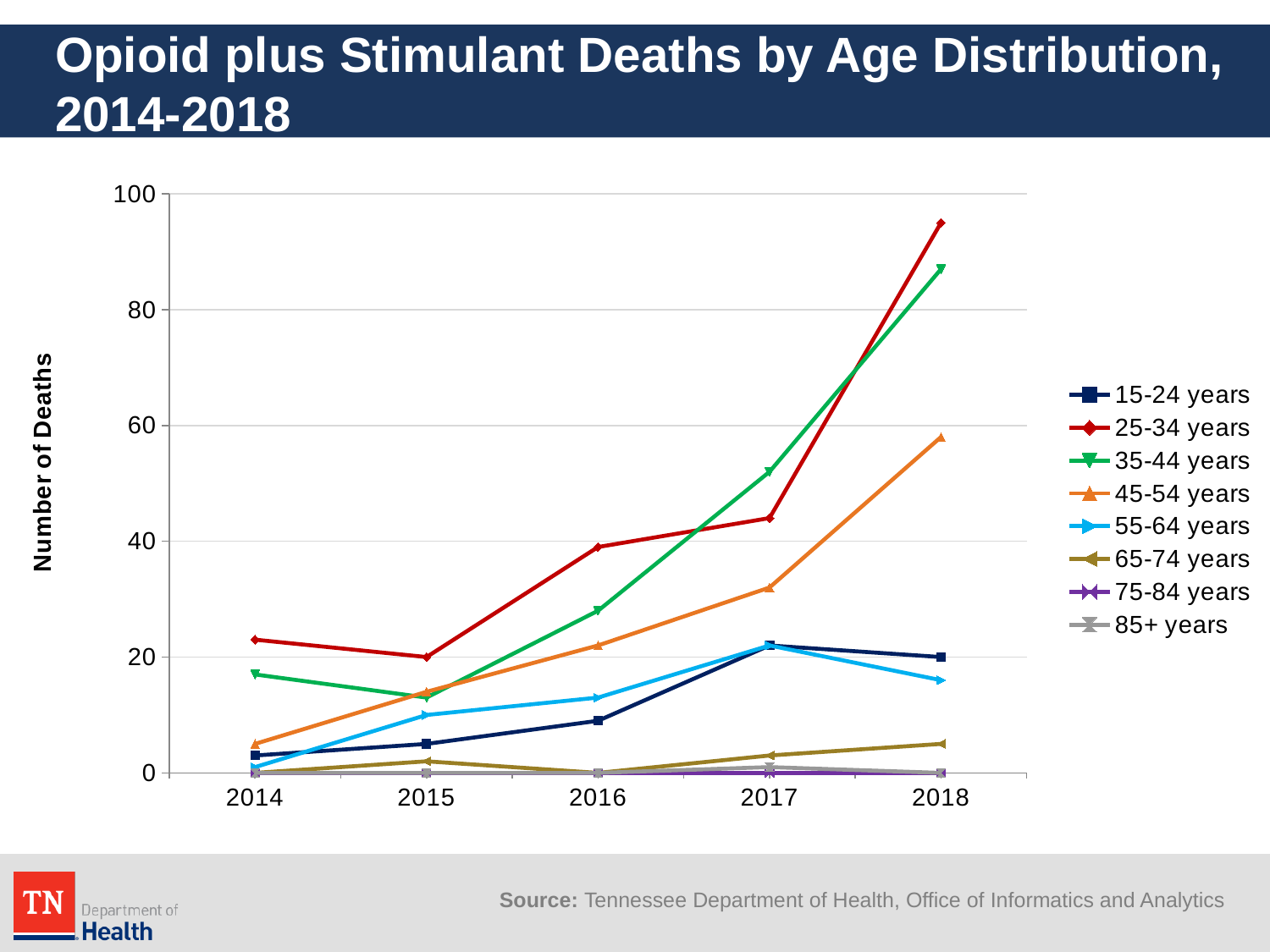
Is the value for 25-34 years in 2018 greater or less than 80? greater How many series does the legend list? 8 Is the value for 35-44 years in 2017 greater or less than 40? greater How many years are shown along the x axis? 5 Is the value for 15-24 years in 2016 greater or less than 20? less In 2014, which is larger: the value for 25-34 years or the value for 35-44 years? 25-34 years What kind of chart is shown on the slide? line chart Which age group has the highest number of deaths in 2018? 25-34 years Do the values for 55-64 years rise or fall from 2017 to 2018? fall What is the label on the y axis? Number of Deaths Do the values for 25-34 years rise or fall from 2016 to 2018? rise